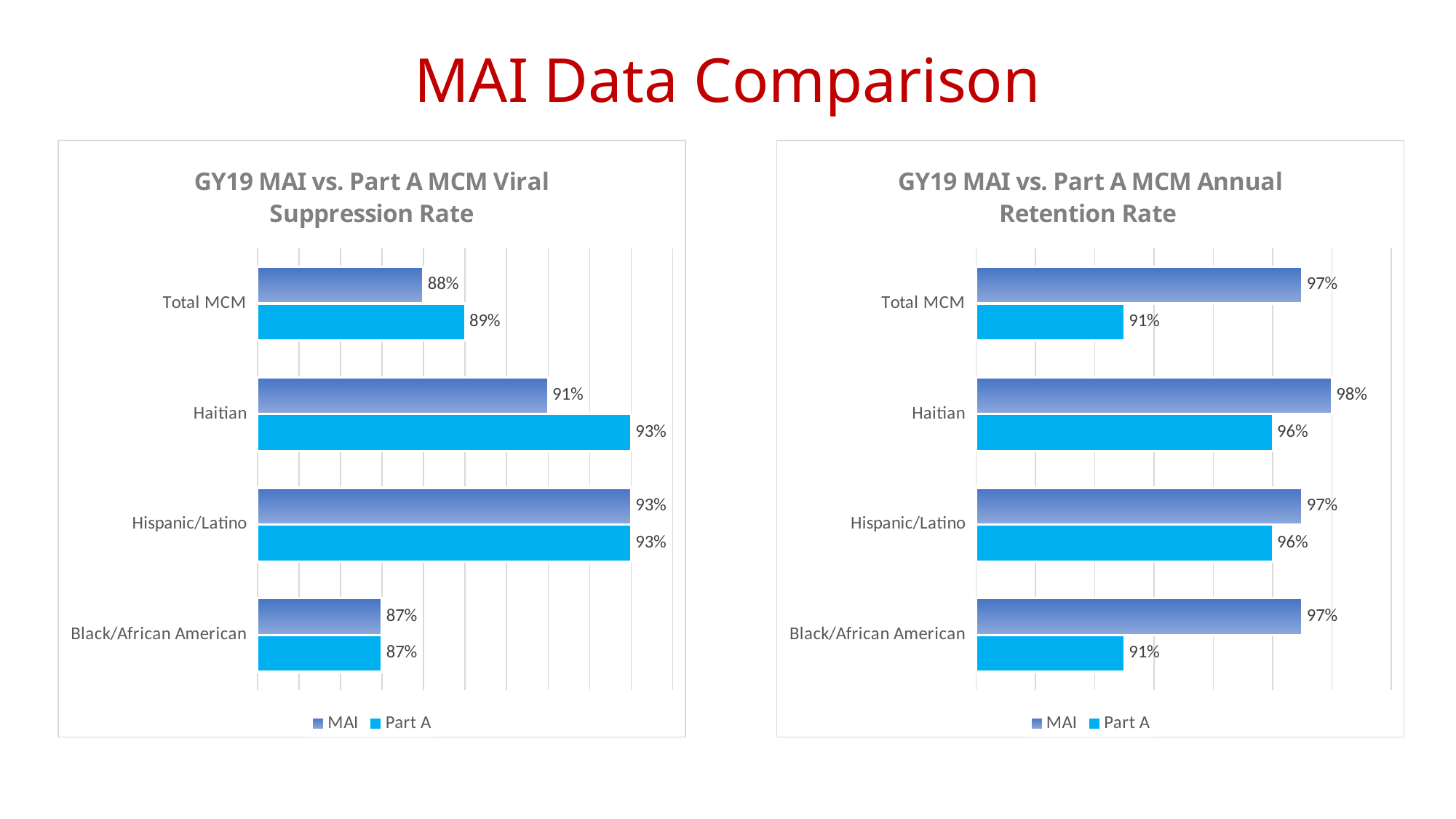
What type of chart is the Annual Retention Rate chart? Bar chart In the Annual Retention Rate chart, what is the MAI value for Haitian? 98% In the Viral Suppression Rate chart, what is the difference between the Part A and MAI values for Haitian? 2% How many series does the legend of the Viral Suppression Rate chart list? 2 In the Viral Suppression Rate chart, which category has the lowest Part A value? Black/African American In the Viral Suppression Rate chart, what is the Part A value for Total MCM? 89% In the Annual Retention Rate chart, which category has the highest MAI value? Haitian In the Annual Retention Rate chart, what is the Part A value for Black/African American? 91% In the Viral Suppression Rate chart, which is larger for Total MCM, the MAI value or the Part A value? Part A In the Annual Retention Rate chart, what is the difference between the MAI and Part A values for Total MCM? 6% In the Viral Suppression Rate chart, what is the MAI value for Haitian? 91% How many categories are shown in the Annual Retention Rate chart? 4